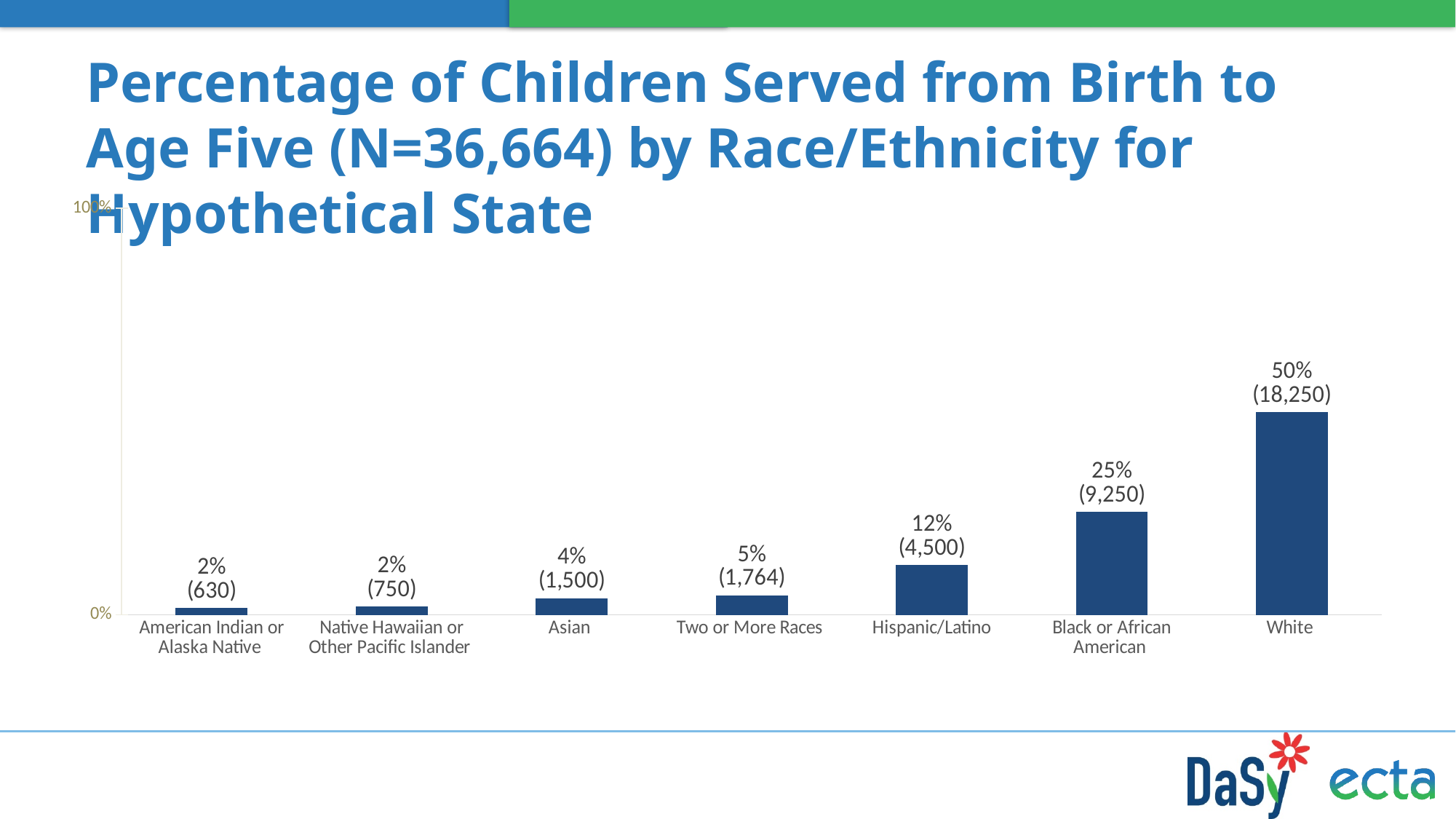
What percentage of children served are Native Hawaiian or Other Pacific Islander? 2% What is the total N stated in the chart title? 36,664 Do the values generally rise or fall moving from left to right along the x axis? Rise What is the difference in percentage points between White and Black or African American? 25% Which race/ethnicity category has the highest percentage of children served? White How many children served are Hispanic/Latino, according to the data label? 4,500 What percentage of children served are Black or African American? 25% Which is larger, the percentage for Asian or the percentage for Two or More Races? Two or More Races What is the difference in the number of children between Black or African American (9,250) and Hispanic/Latino (4,500)? 4,750 What kind of chart is shown on the slide? Bar chart What percentage of children served are White? 50% How many race/ethnicity categories are shown on the chart? 7